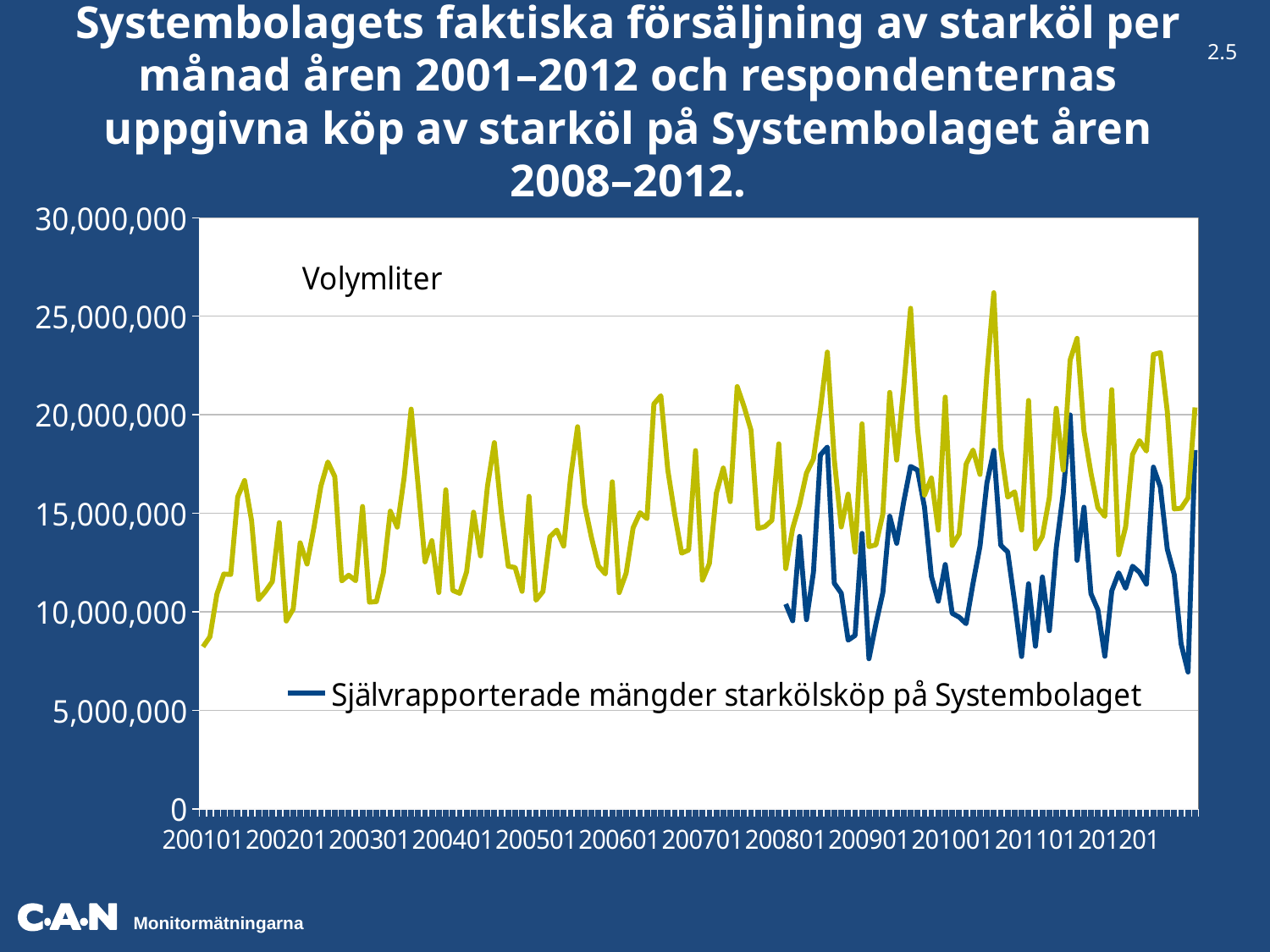
Is the highest peak of the yellow line greater or less than 25,000,000? greater At which x-axis label does the blue line (Självrapporterade mängder starkölsköp på Systembolaget) begin? 200801 Which line starts earlier on the x axis, the yellow line or the blue line? the yellow line Does the yellow line ever exceed 30,000,000? No What is the highest value shown on the vertical axis? 30,000,000 Is the value of the yellow line at 200101 greater or less than 5,000,000? greater What kind of chart is shown on the slide? line chart What unit label is printed inside the plot area? Volymliter How many year labels are printed along the x axis? 12